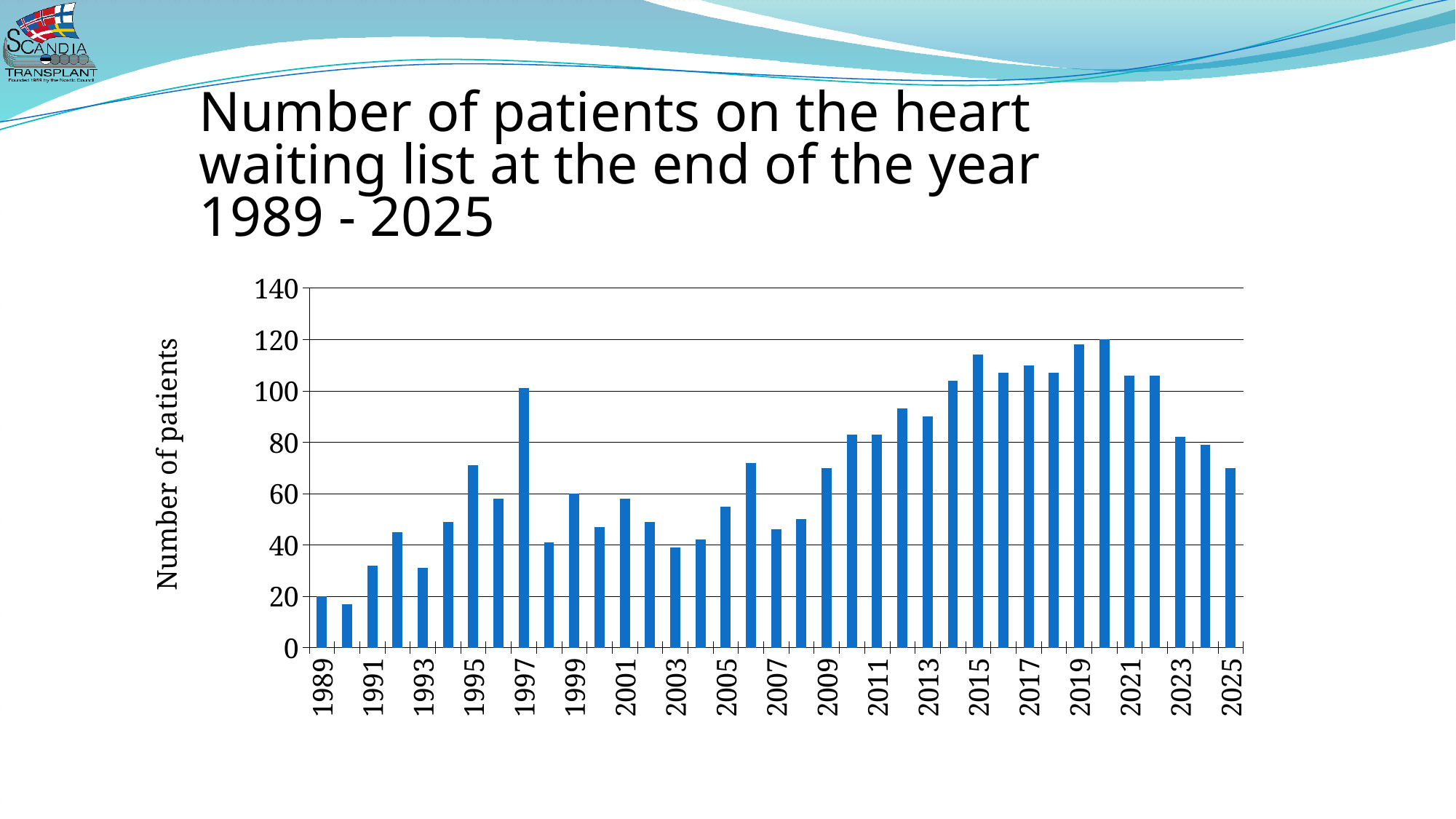
Is the value for 2003 greater or less than 60? less Which year has the larger value, 1996 or 1997? 1997 Do the values rise or fall from 2020 to 2025? fall What kind of chart is shown on the slide? bar chart What is the title of the chart on the slide? Number of patients on the heart waiting list at the end of the year 1989 - 2025 Is the value for 1990 greater or less than 40? less How many years (bars) are plotted in the chart? 37 Which year has the larger value, 2024 or 2025? 2024 Is the value for 2015 greater or less than 100? greater What is the label of the vertical axis? Number of patients